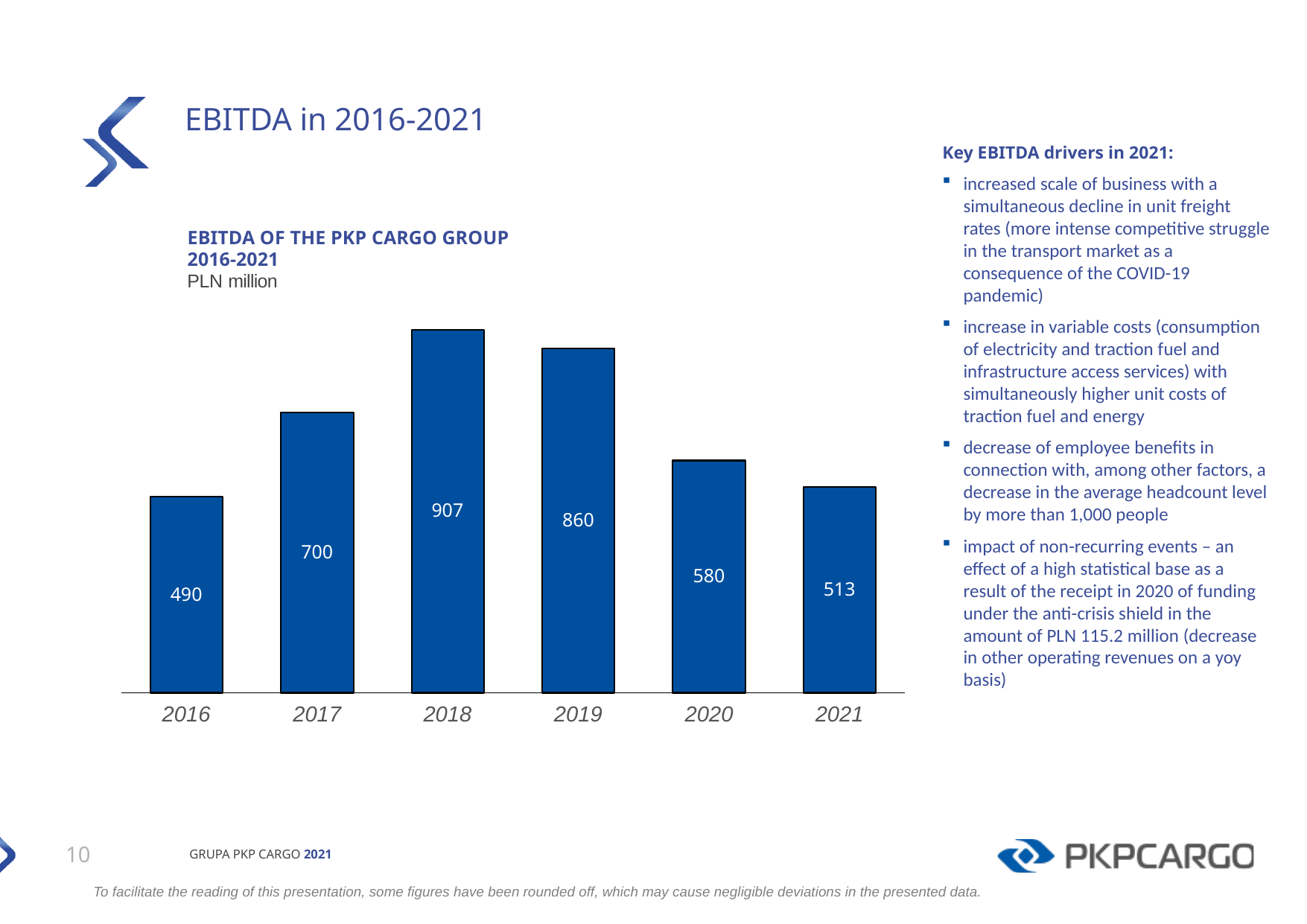
How many years are shown on the chart? 6 Which year had the highest EBITDA? 2018 What is the difference between the EBITDA in 2018 and in 2019? 47 Which year had the lowest EBITDA? 2016 What was the EBITDA of the PKP Cargo Group in 2018? 907 What was the EBITDA of the PKP Cargo Group in 2016? 490 Did EBITDA rise or fall from 2018 to 2021? Fall What was the EBITDA of the PKP Cargo Group in 2021? 513 What type of chart is used to show EBITDA? Bar chart In what unit are the EBITDA values shown? PLN million By how much did EBITDA fall from 2020 to 2021? 67 Which year had a higher EBITDA, 2017 or 2020? 2017